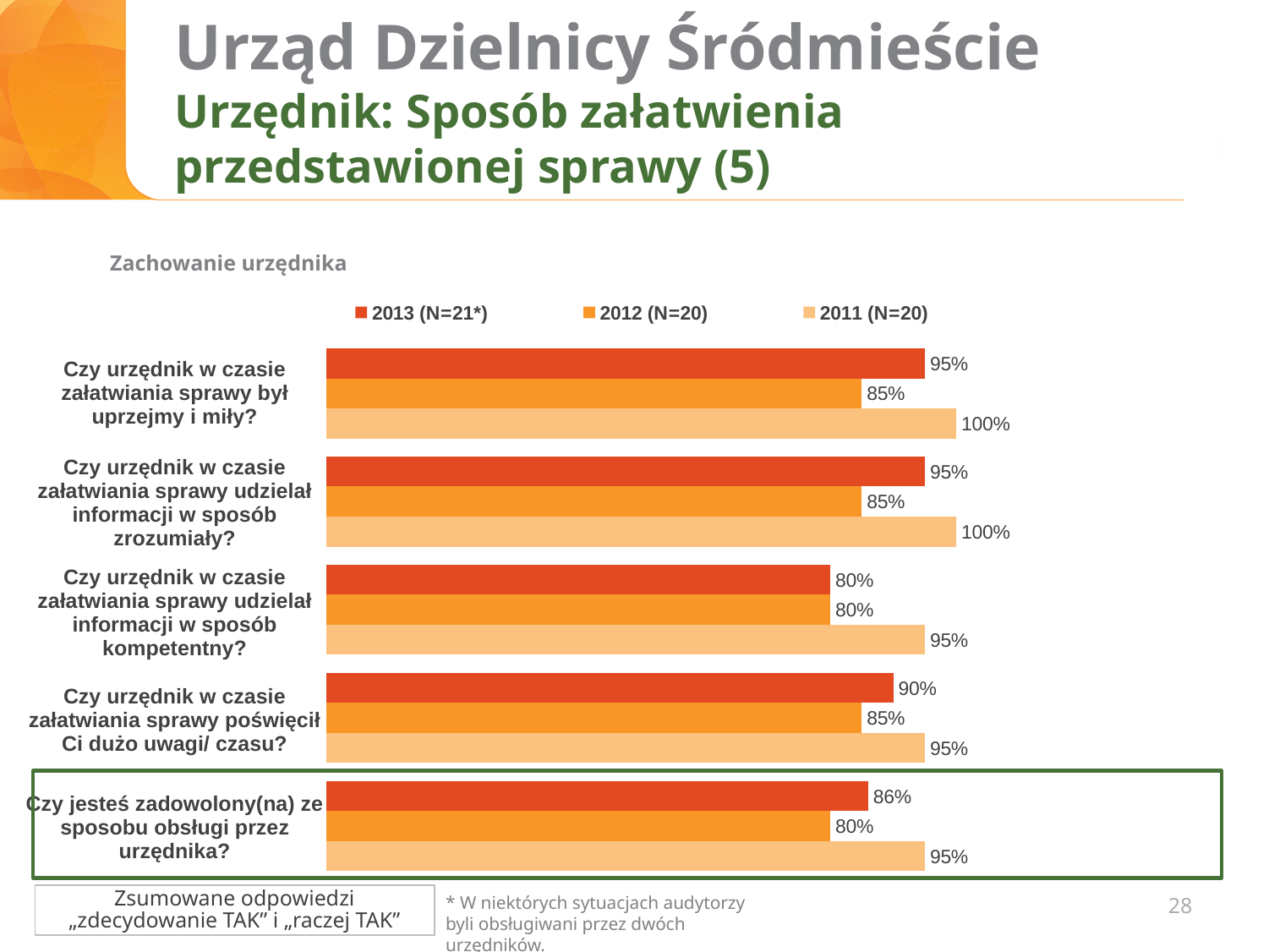
What is the sample size shown in the legend for the 2013 series? N=21* Which category has the lowest 2013 value? Czy urzędnik w czasie załatwiania sprawy udzielał informacji w sposób kompetentny? What is the 2011 value for "Czy urzędnik w czasie załatwiania sprawy był uprzejmy i miły?"? 100% What is the title shown above the chart? Zachowanie urzędnika How many series does the chart legend list? 3 What kind of chart is shown on the slide? bar chart What is the 2013 value for "Czy jesteś zadowolony(na) ze sposobu obsługi przez urzędnika?"? 86% What is the 2012 value for "Czy urzędnik w czasie załatwiania sprawy udzielał informacji w sposób kompetentny?"? 80% How many question categories are plotted in the chart? 5 For "Czy urzędnik w czasie załatwiania sprawy poświęcił Ci dużo uwagi/ czasu?", which is larger: the 2013 value or the 2012 value? 2013 What is the difference between the 2011 and 2012 values for "Czy urzędnik w czasie załatwiania sprawy był uprzejmy i miły?"? 15% What is the difference between the 2013 and 2012 values for "Czy jesteś zadowolony(na) ze sposobu obsługi przez urzędnika?"? 6%